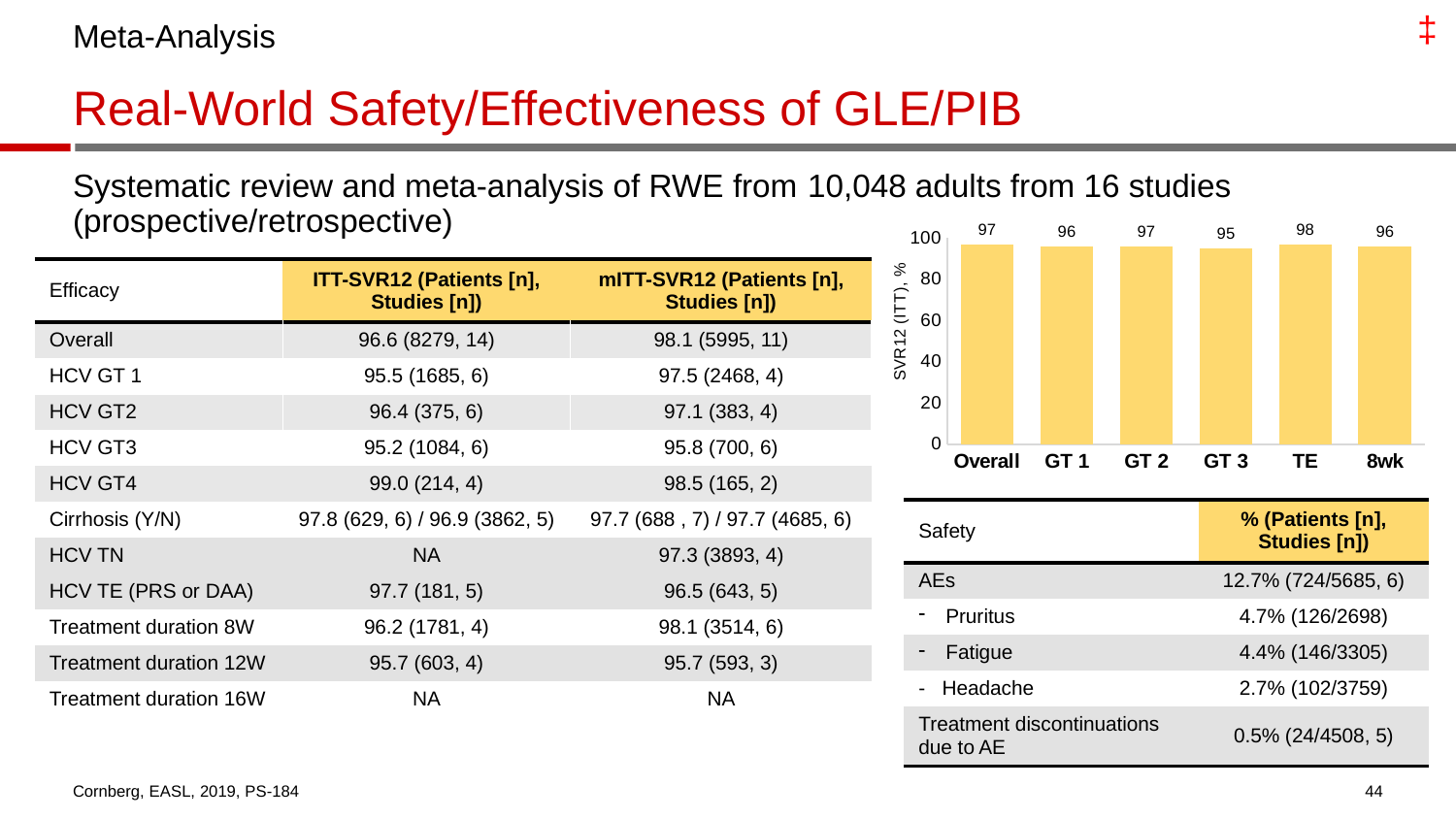
What is the label of the y axis of the bar chart? SVR12 (ITT), % What is the SVR12 (ITT) value shown for GT 3 in the bar chart? 95 What is the SVR12 (ITT) value shown for 8wk in the bar chart? 96 How many categories are shown on the x axis of the bar chart? 6 Which category has the lowest SVR12 (ITT) value in the bar chart? GT 3 Is the SVR12 (ITT) value for GT 1 in the bar chart greater or less than 80? greater Which category has the highest SVR12 (ITT) value in the bar chart? TE What is the SVR12 (ITT) value shown for TE in the bar chart? 98 What type of chart is used to show SVR12 (ITT) by category? Bar chart What is the difference between the SVR12 (ITT) values for TE and GT 3 in the bar chart? 3 What is the SVR12 (ITT) value shown for Overall in the bar chart? 97 In the bar chart, which has a higher SVR12 (ITT) value, GT 2 or GT 3? GT 2